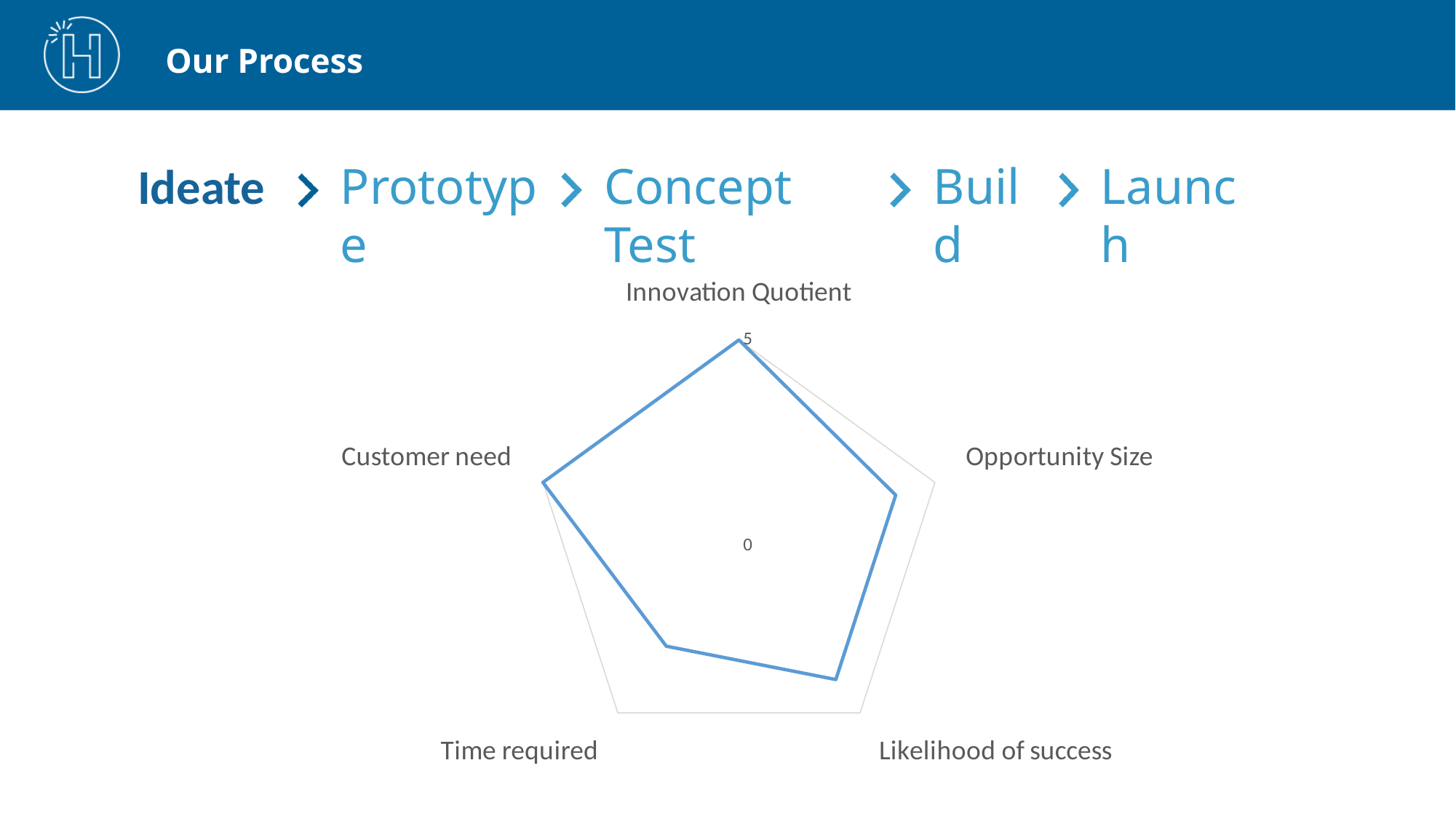
What is the maximum value shown on the radar chart's scale? 5 Which is larger on the radar chart, Opportunity Size or Time required? Opportunity Size Is the value for Likelihood of success greater or less than 0? greater What is the value for Customer need on the radar chart? 5 What kind of chart is shown on the slide? Radar chart Which is larger on the radar chart, Innovation Quotient or Likelihood of success? Innovation Quotient How many categories (axes) does the radar chart have? 5 Is the value for Opportunity Size greater or less than 5? less Which category has the lowest value on the radar chart? Time required Which category label appears at the top of the radar chart? Innovation Quotient Is the value for Time required greater or less than 5? less What is the value for Innovation Quotient on the radar chart? 5